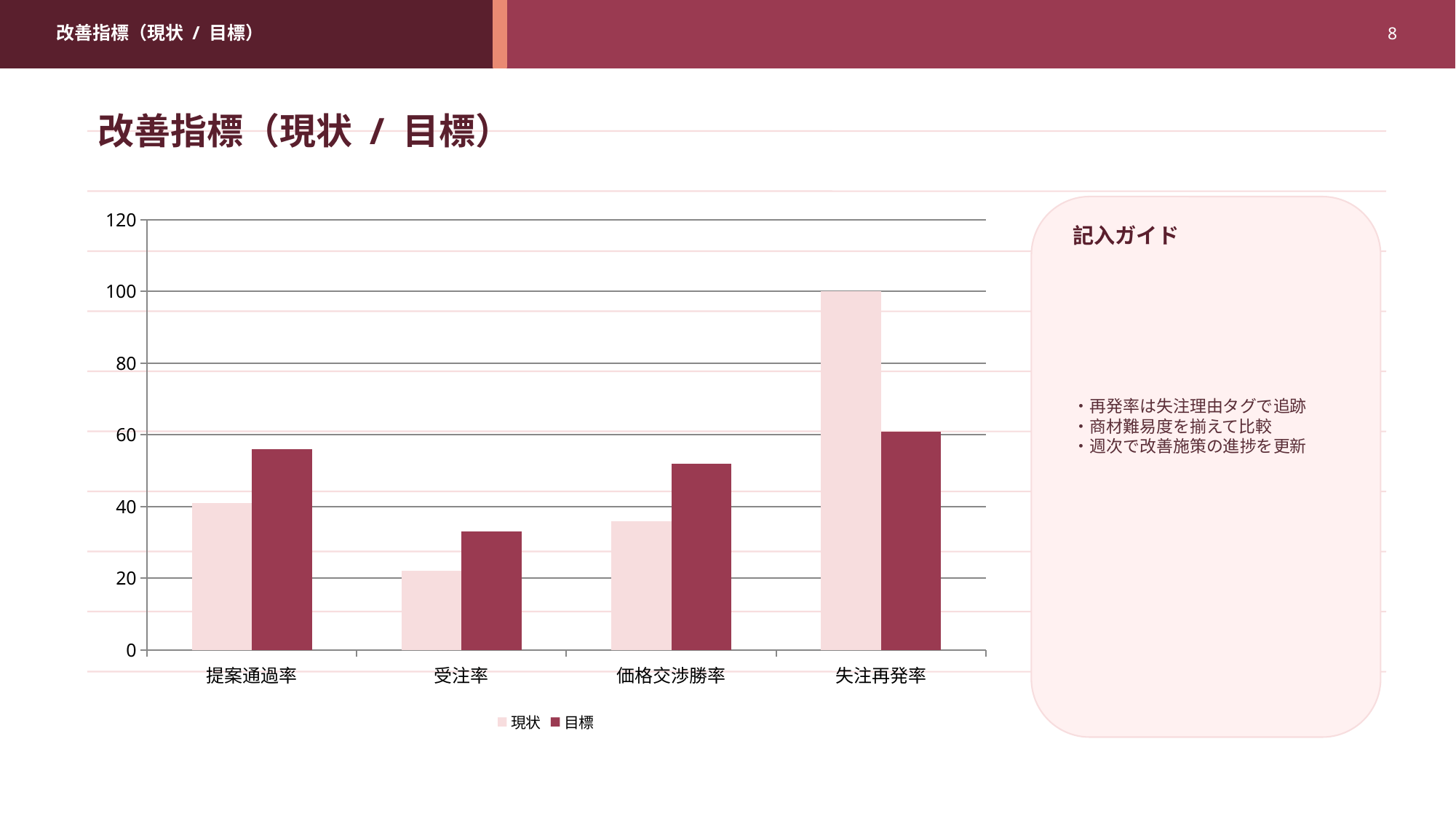
Is the 目標 value for 提案通過率 greater or less than 40? greater What kind of chart is shown on the slide? bar chart Which category has the lowest 目標 value? 受注率 What is the 現状 value for 失注再発率? 100 Which category has the highest 現状 value? 失注再発率 How many categories are shown on the x axis of the chart? 4 What are the two series named in the chart legend? 現状 and 目標 Which category has the lowest 現状 value? 受注率 For 失注再発率, which is larger, the 現状 value or the 目標 value? 現状 How many series does the chart legend list? 2 For 価格交渉勝率, which is larger, the 現状 value or the 目標 value? 目標 Is the 現状 value for 受注率 greater or less than 40? less